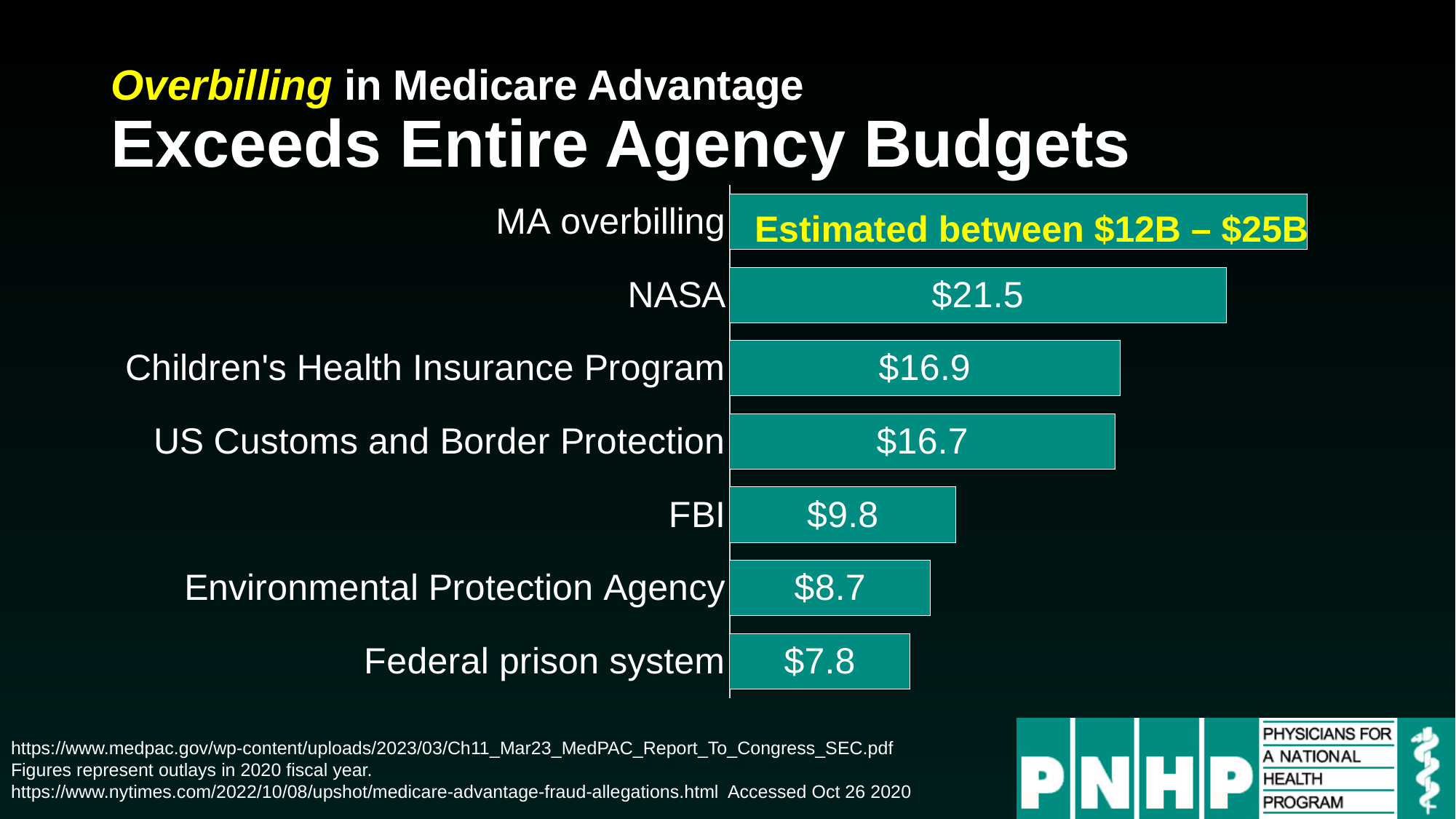
How many categories are shown in the chart? 7 Which is larger, the value for US Customs and Border Protection or the value for the Environmental Protection Agency? US Customs and Border Protection Which category has the smallest value? Federal prison system What label is printed on the MA overbilling bar? Estimated between $12B – $25B What value is shown for the Federal prison system? $7.8 What colour are the bars in the chart? Teal Which category has the longest bar? MA overbilling What is the difference between the NASA value and the FBI value? $11.7 What value is shown for the Children's Health Insurance Program? $16.9 What value is shown for NASA? $21.5 What value is shown for the FBI? $9.8 What kind of chart is shown on the slide? Bar chart